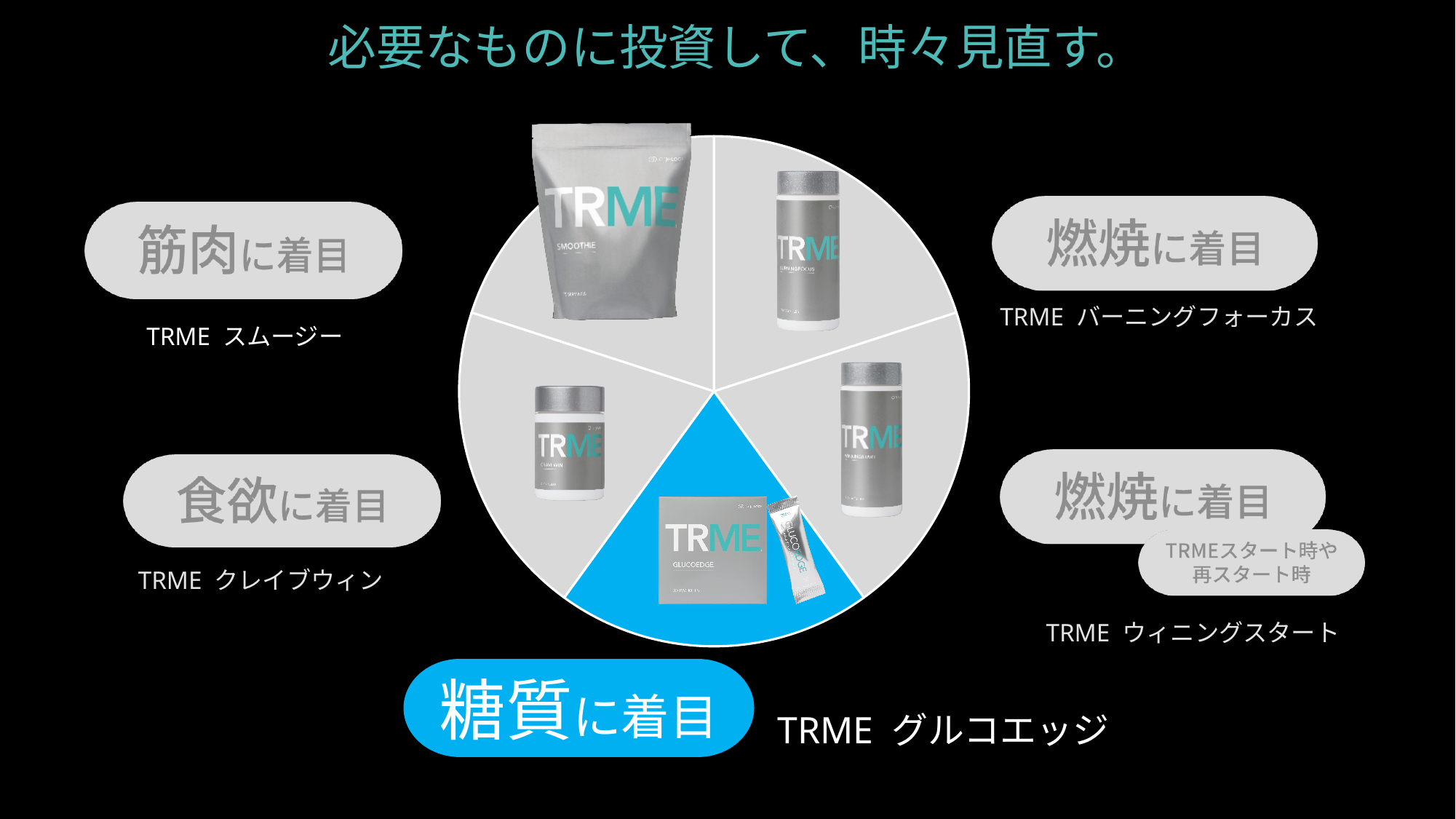
How many slices does the pie chart have? 5 What is the title at the top of the slide? 必要なものに投資して、時々見直す。 Which product is shown in the slice labelled 食欲に着目? TRME クレイブウィン Which product is shown in the slice labelled 筋肉に着目? TRME スムージー What kind of chart is shown in the centre of the slide? pie chart Which product is labelled 糖質に着目? TRME グルコエッジ How many slices of the pie chart are labelled 燃焼に着目? 2 Which slice of the pie chart is highlighted in blue? 糖質に着目 (TRME グルコエッジ)